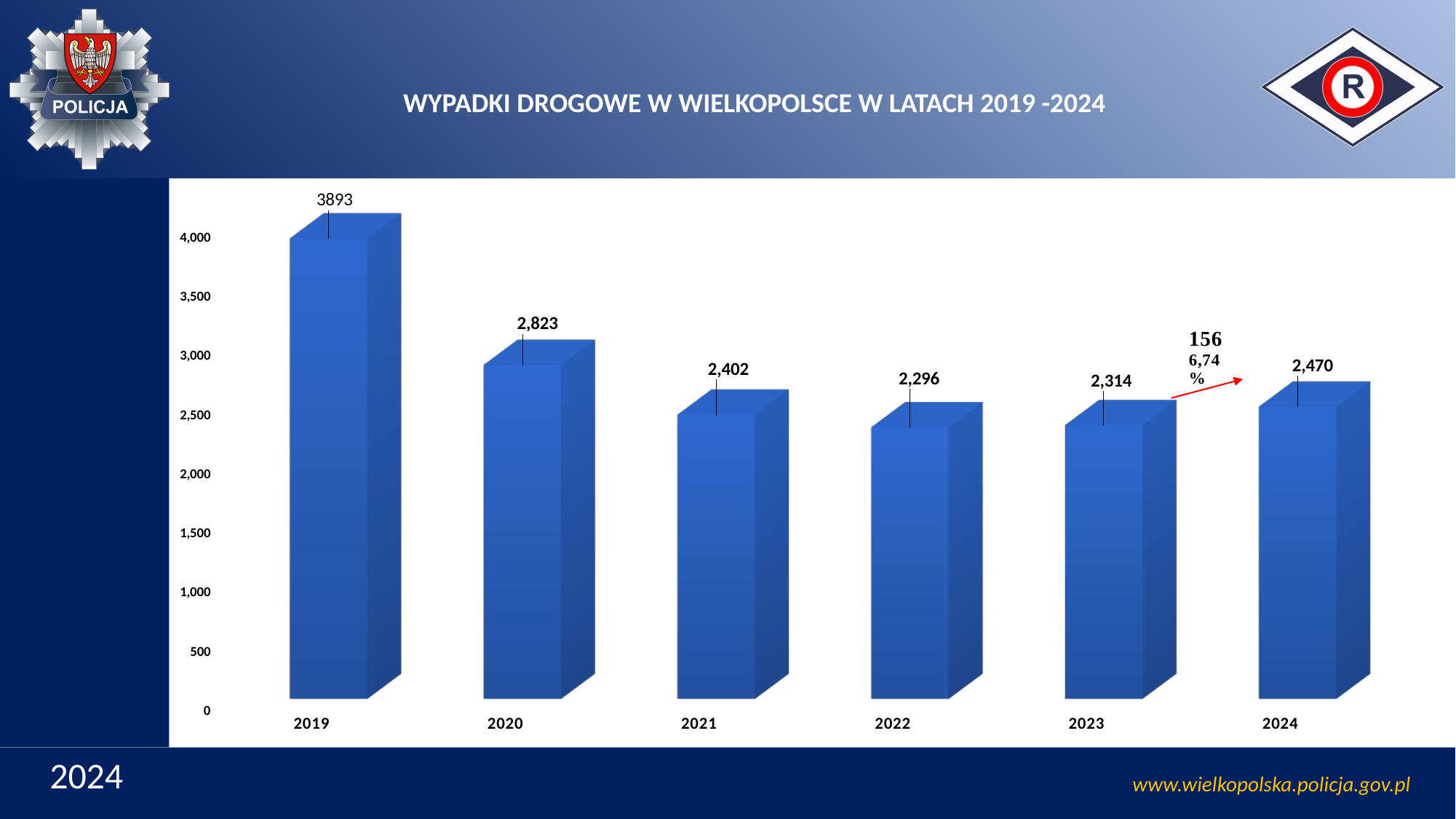
How many years are shown on the x axis? 6 What is the difference between the values for 2023 and 2024? 156 What is the difference between the values for 2019 and 2020? 1,070 What is the value for 2024? 2,470 What is the value for 2022? 2,296 What is the value for 2019? 3893 What is the title of the chart? WYPADKI DROGOWE W WIELKOPOLSCE W LATACH 2019 -2024 Which year has the highest value? 2019 Which is larger, the value for 2021 or the value for 2023? 2021 What kind of chart is shown on the slide? bar chart Is the value for 2020 greater or less than 3,000? less Which year has the lowest value? 2022